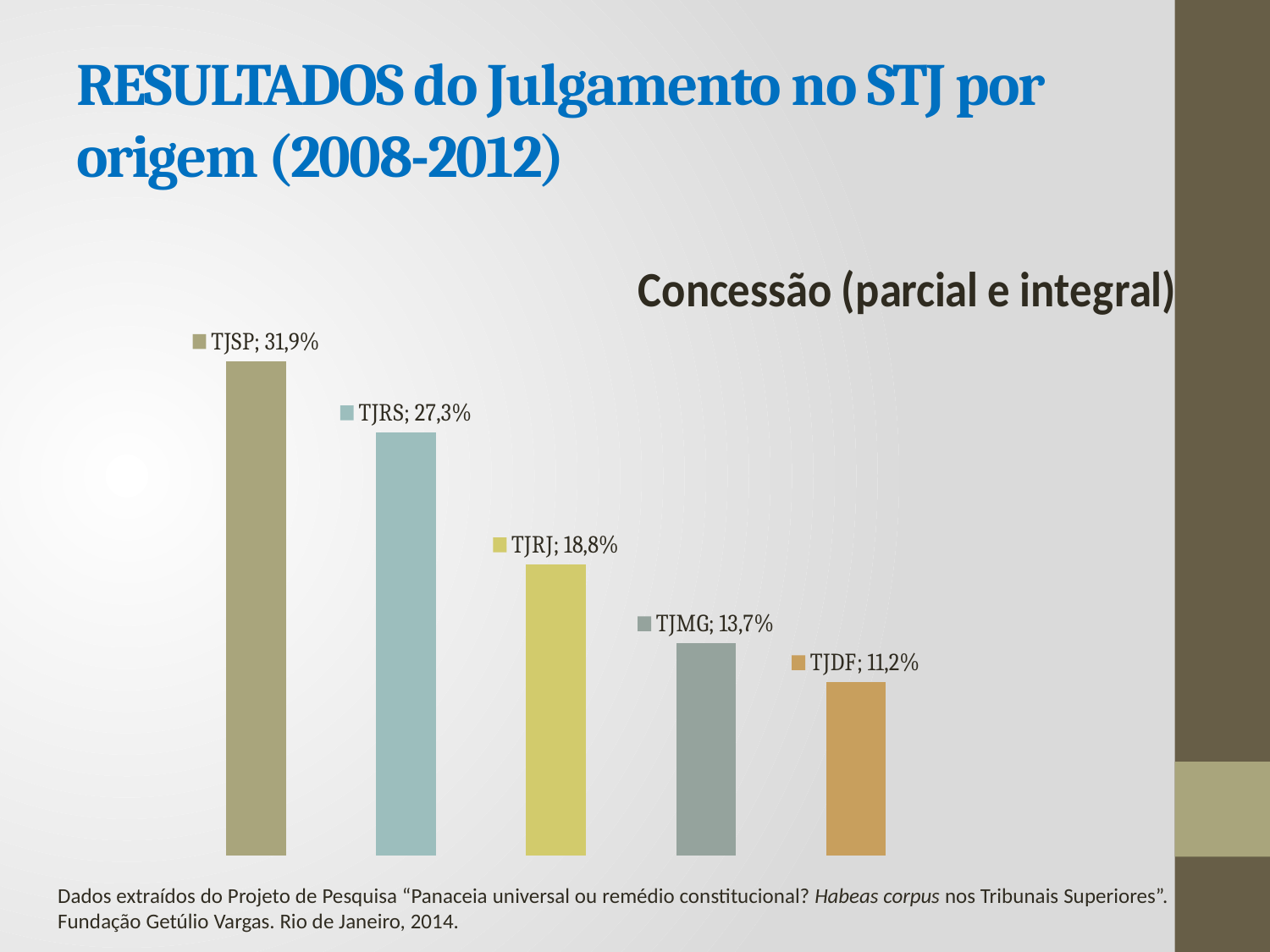
Which court has the lowest value? TJDF What is the difference between the values for TJSP and TJDF? 20,7% What is the value for TJRJ? 18,8% How many courts are shown in the chart? 5 What is the value for TJSP? 31,9% What is the value for TJRS? 27,3% What is the value for TJDF? 11,2% What is the difference between the values for TJSP and TJRS? 4,6% What is the value for TJMG? 13,7% Which is larger, the value for TJRJ or the value for TJMG? TJRJ What kind of chart is shown on the slide? Bar chart Which court has the highest value? TJSP